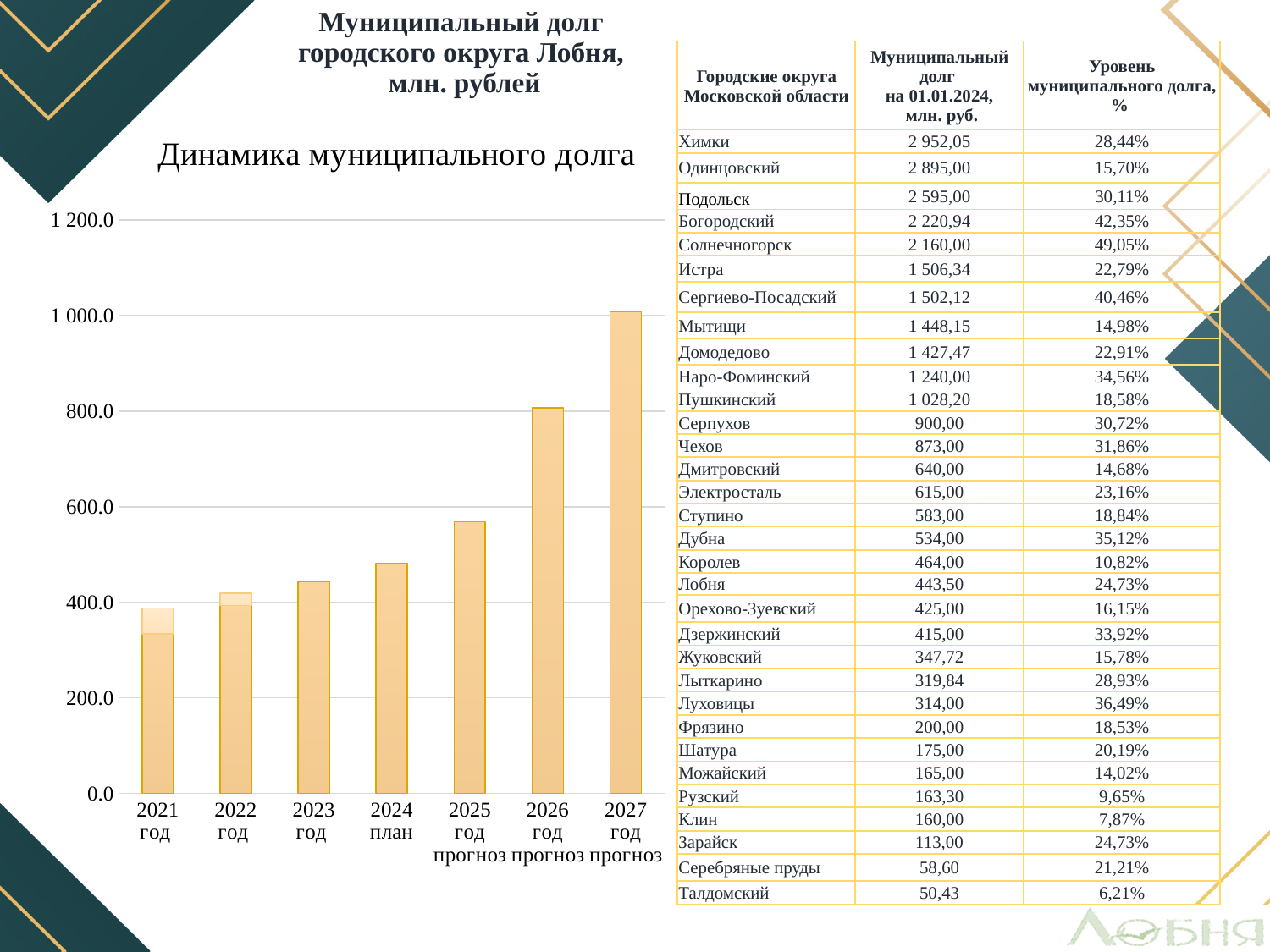
Is the value for 2027 год прогноз greater or less than 800.0? greater What kind of chart is shown on the slide? bar chart Which category has the highest bar in the chart? 2027 год прогноз Is the value for 2024 план greater or less than 600.0? less Which is larger, the value for 2024 план or 2025 год прогноз? 2025 год прогноз Do the values in the chart rise or fall from 2021 to 2027? rise Is the value for 2023 год greater or less than 600.0? less Which is larger, the value for 2026 год прогноз or 2027 год прогноз? 2027 год прогноз What is the title of the chart? Динамика муниципального долга How many categories are shown on the x axis of the chart? 7 Which category has the lowest bar in the chart? 2021 год